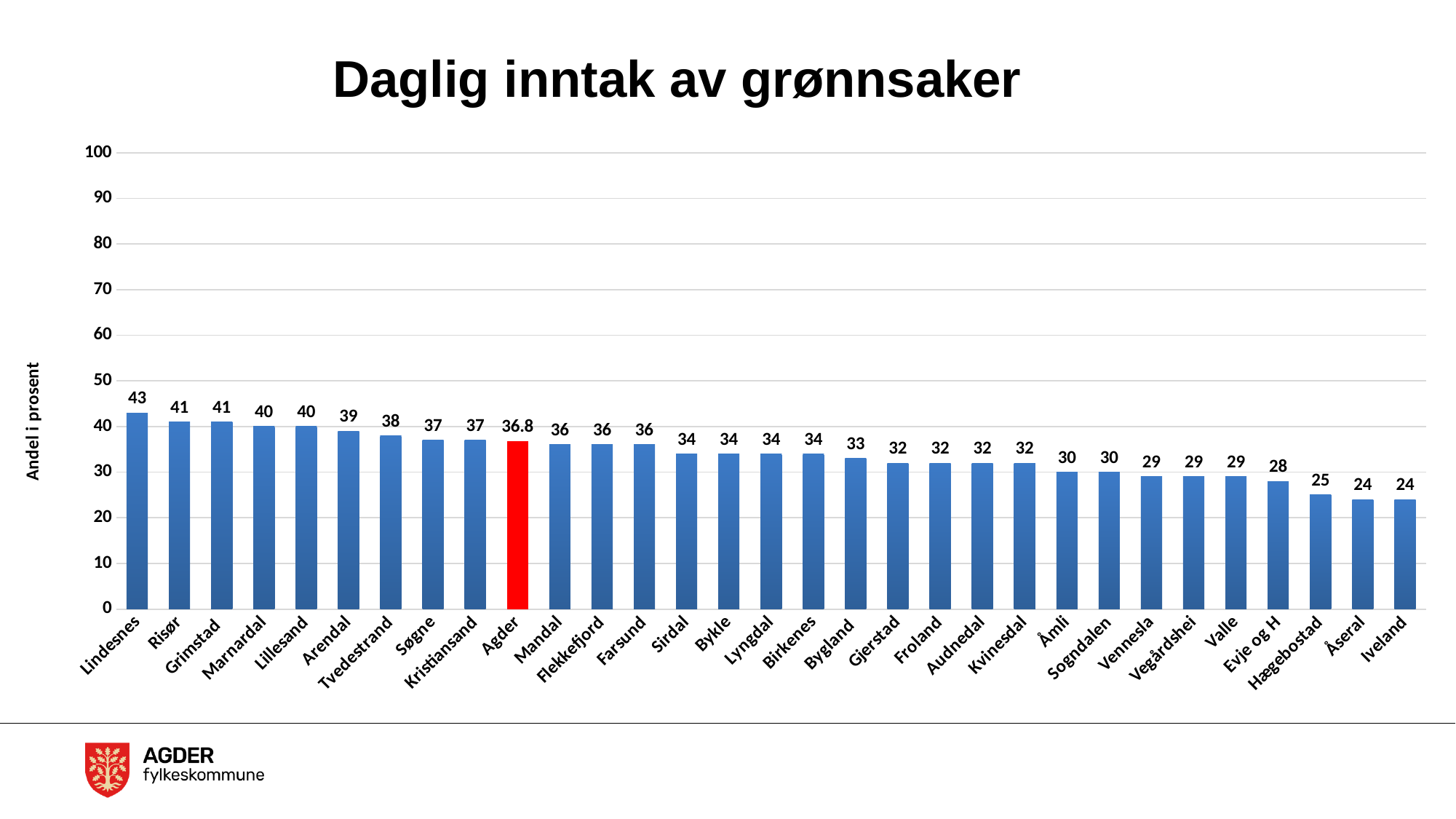
Is the value for Hægebostad greater or less than 30? less What is the title of the chart? Daglig inntak av grønnsaker Which is larger, the value for Arendal or the value for Mandal? Arendal What is the value for Vennesla? 29 What is the value for Agder, the red bar? 36.8 What is the difference between the values for Lindesnes and Iveland? 19 What kind of chart is this? bar chart How many categories are shown on the x axis? 31 Which category has the highest value? Lindesnes What is the lowest value shown on the chart? 24 What is the value for Kristiansand? 37 What is the value for Lindesnes? 43